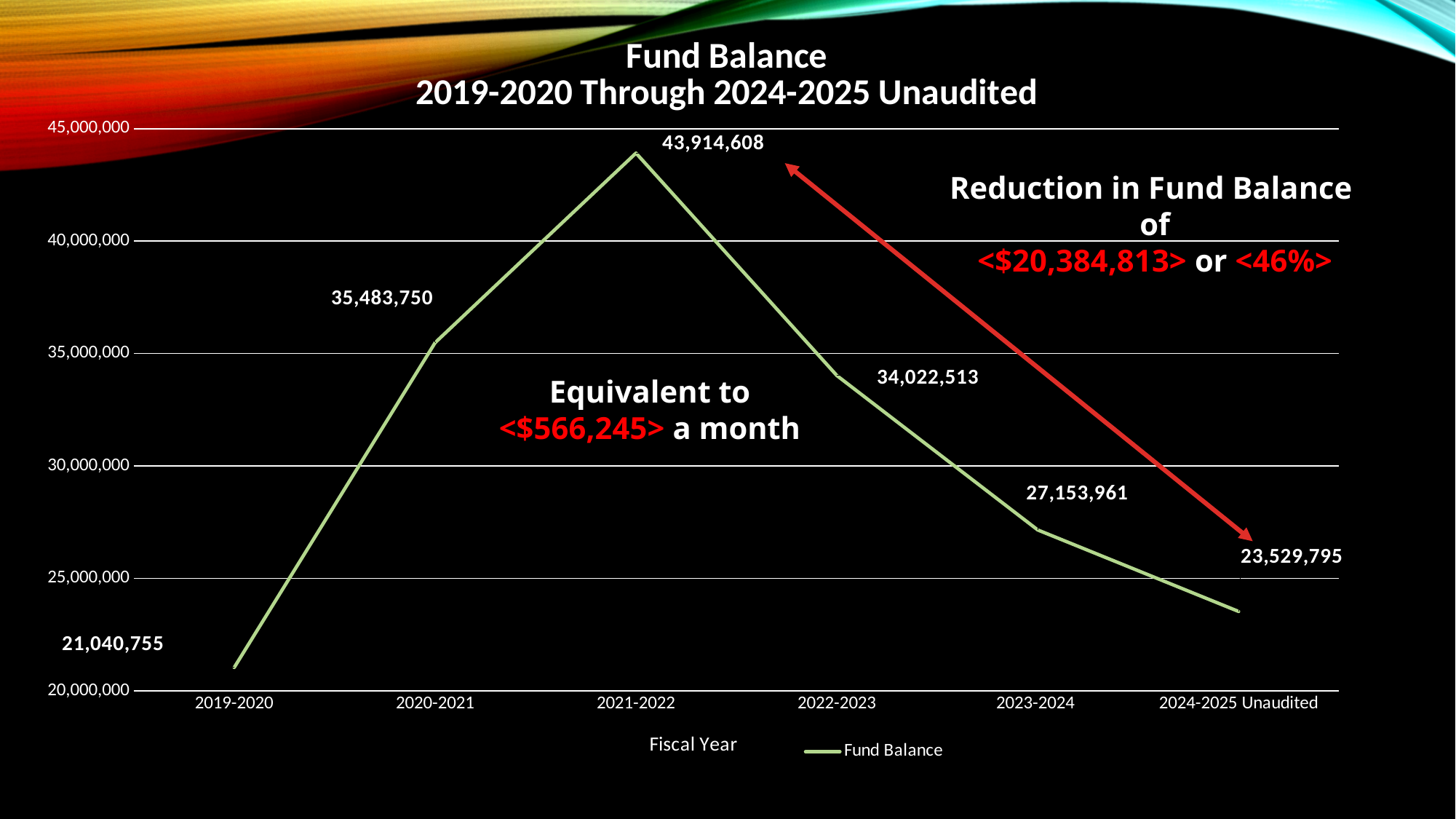
What is the fund balance for 2019-2020? 21,040,755 Which is larger, the fund balance for 2020-2021 or for 2022-2023? 2020-2021 How many fiscal years are plotted on the chart? 6 What is the fund balance for 2024-2025 Unaudited? 23,529,795 What is the fund balance for 2022-2023? 34,022,513 What is the fund balance for 2021-2022? 43,914,608 Which fiscal year has the highest fund balance? 2021-2022 What kind of chart is shown on the slide? line chart Which fiscal year has the lowest fund balance? 2019-2020 Does the fund balance rise or fall from 2021-2022 to 2024-2025 Unaudited? fall Is the fund balance for 2023-2024 greater or less than 30,000,000? less What is the difference between the fund balance in 2021-2022 and in 2024-2025 Unaudited? 20,384,813